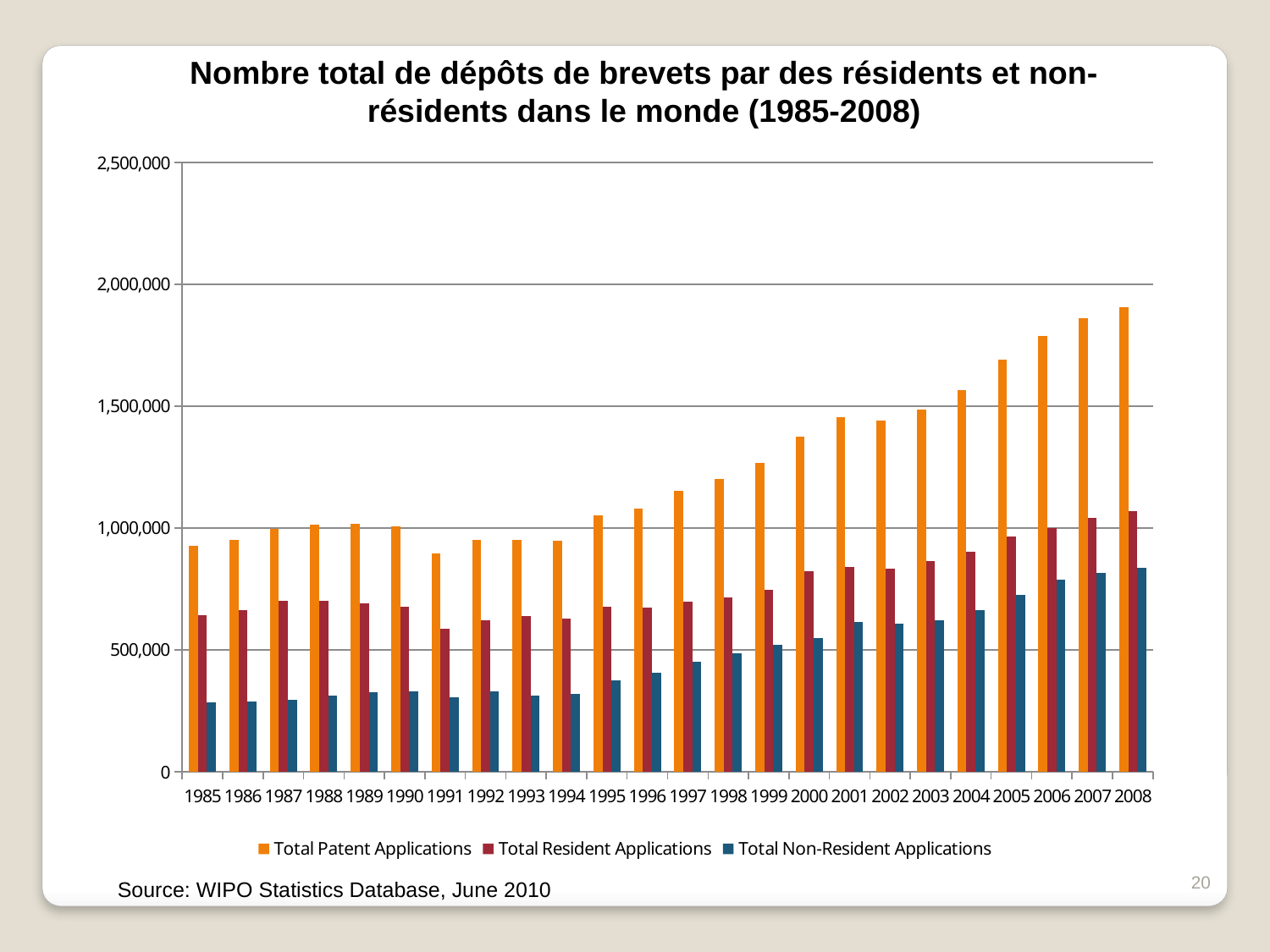
Is the value for Total Patent Applications in 2008 greater or less than 1,500,000? greater How many years are shown on the x axis? 24 Is the value for Total Non-Resident Applications in 1985 greater or less than 500,000? less What kind of chart is shown on the slide? bar chart In which year is the value for Total Resident Applications highest? 2008 How many series does the legend list? 3 Is the value for Total Patent Applications in 2000 greater or less than 1,500,000? less Do the values for Total Patent Applications generally rise or fall from 1995 to 2008? rise In which year is the value for Total Patent Applications highest? 2008 In 2008, which is larger: Total Resident Applications or Total Non-Resident Applications? Total Resident Applications